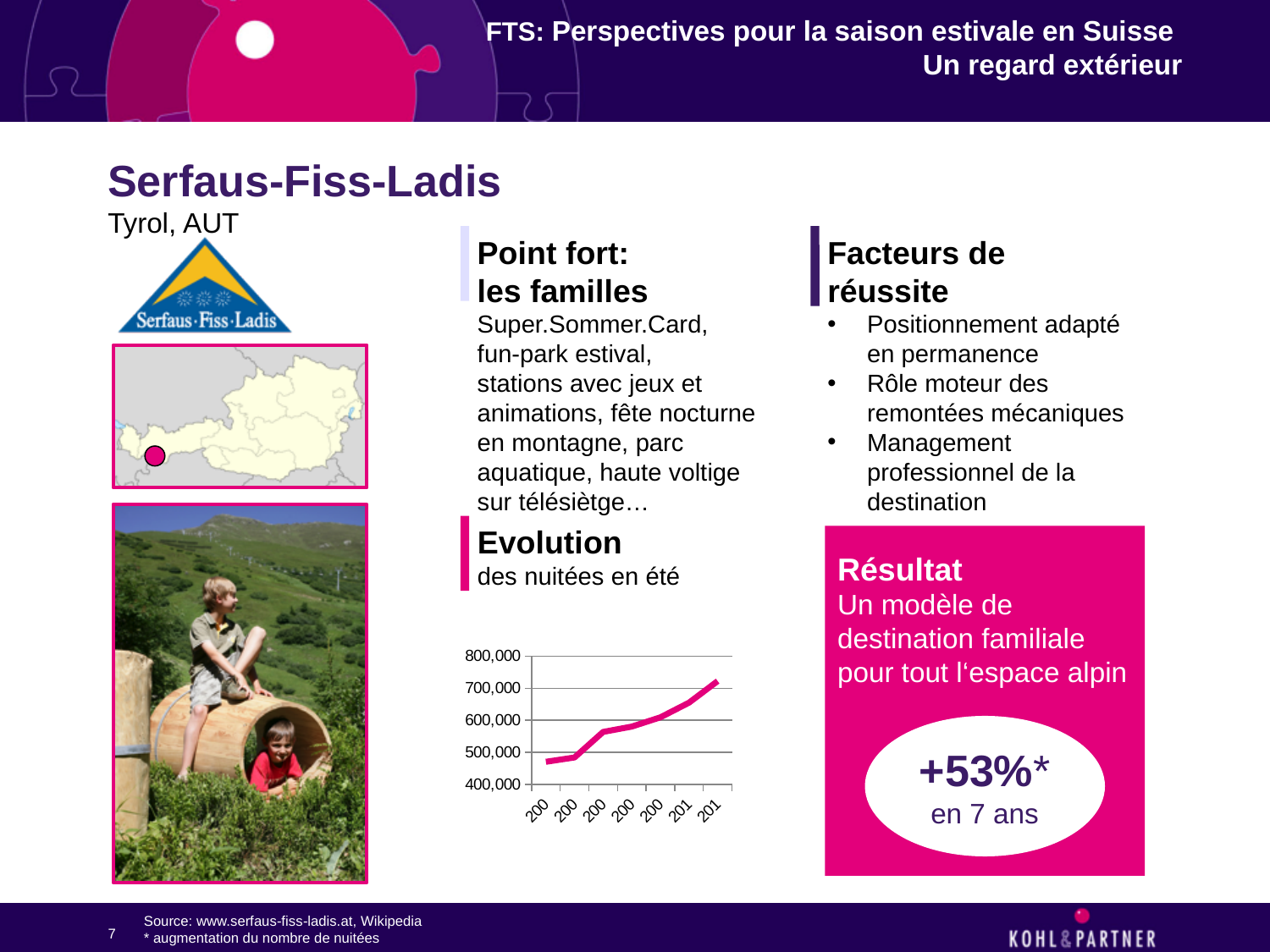
Do the values in the "Evolution des nuitées en été" chart rise or fall from left to right along the x axis? rise What is the highest value shown on the y axis of the "Evolution des nuitées en été" chart? 800,000 How many data points are plotted in the "Evolution des nuitées en été" line chart? 7 In the "Evolution des nuitées en été" chart, is the value of the last (rightmost) point greater or less than 800,000? less In the "Evolution des nuitées en été" chart, is the value of the third point from the left greater or less than 500,000? greater In the "Evolution des nuitées en été" chart, is the value of the last (rightmost) point greater or less than 600,000? greater What kind of chart is shown under the heading "Evolution des nuitées en été"? line chart What colour is the line in the "Evolution des nuitées en été" chart? pink